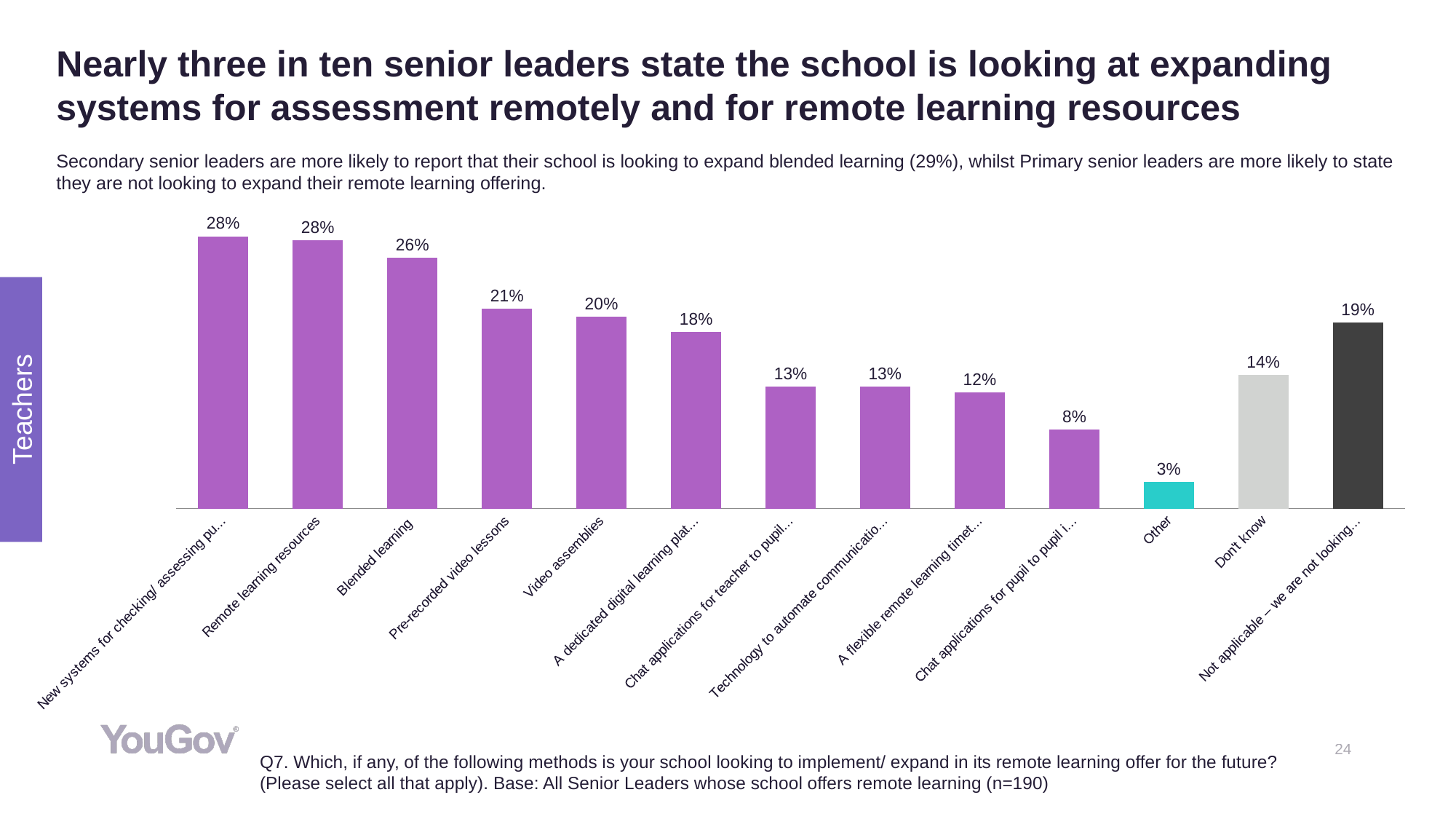
What percentage of senior leaders selected Pre-recorded video lessons? 21% What is the difference between the values for Blended learning and Video assemblies? 6% What is the value shown for Video assemblies? 20% What percentage is shown for Blended learning? 26% What colour is the bar for Other? Teal Which is larger, the value for Don't know or the value for Video assemblies? Video assemblies How many categories (bars) are shown in the chart? 13 What is the difference between the values for Pre-recorded video lessons and Other? 18% What type of chart is shown on the slide? Bar chart What percentage is shown for Don't know? 14% Which category has the lowest value in the chart? Other What is the value for Remote learning resources? 28%